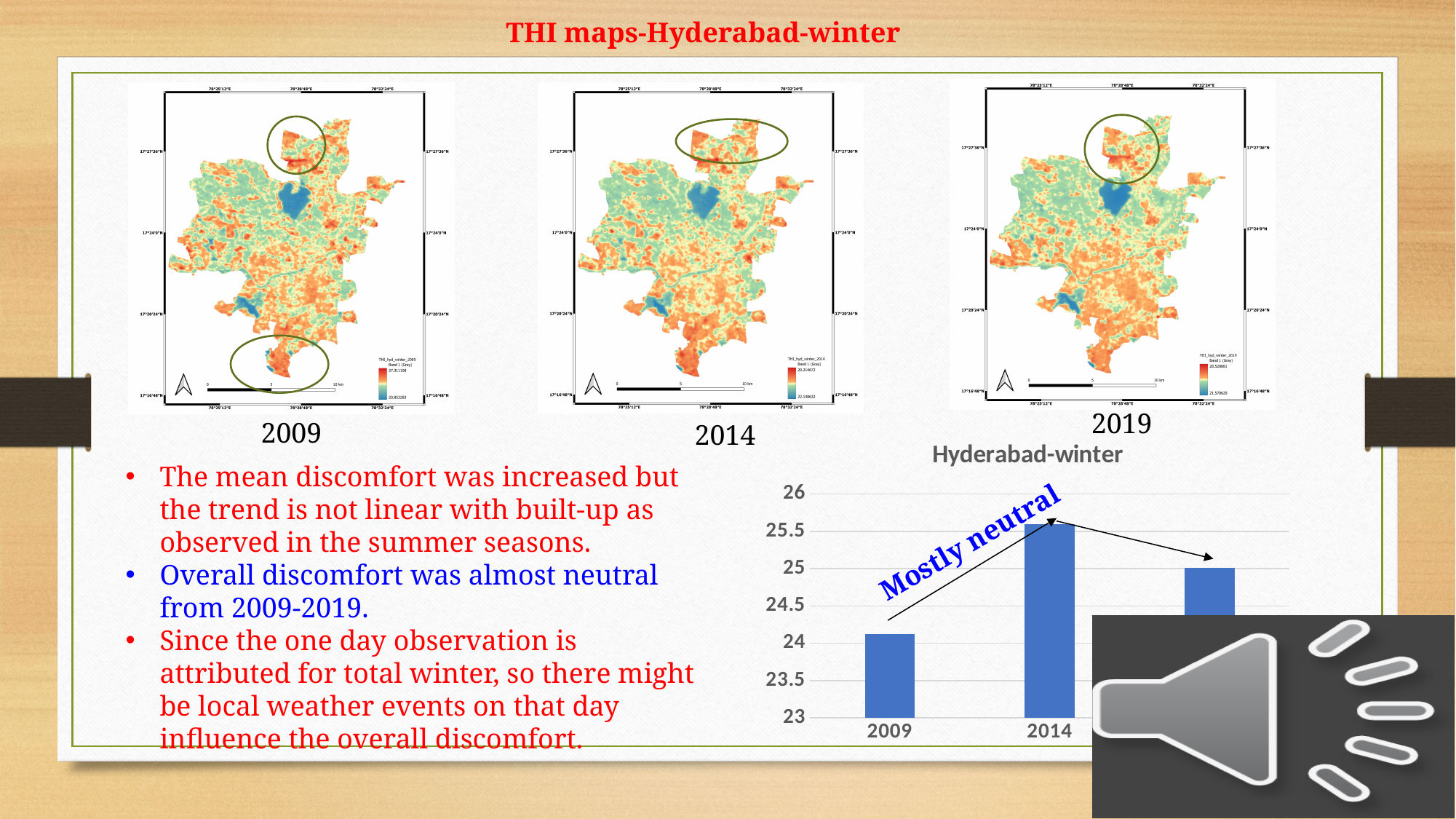
What is the title of the bar chart on the slide? Hyderabad-winter In the Hyderabad-winter bar chart, is the value for 2009 greater or less than 25? less What colour are the bars in the Hyderabad-winter bar chart? blue In the Hyderabad-winter bar chart, which is larger, the value for 2009 or the value for 2014? 2014 In the Hyderabad-winter bar chart, which year has the highest bar? 2014 In the Hyderabad-winter bar chart, how many bars are plotted? 3 In the Hyderabad-winter bar chart, which year has the lowest bar? 2009 In the Hyderabad-winter bar chart, is the value for 2014 greater or less than 25? greater In the Hyderabad-winter bar chart, is the value for 2009 greater or less than 24.5? less In the Hyderabad-winter bar chart, does the value rise or fall from 2009 to 2014? rise What kind of chart is shown under the title 'Hyderabad-winter'? bar chart